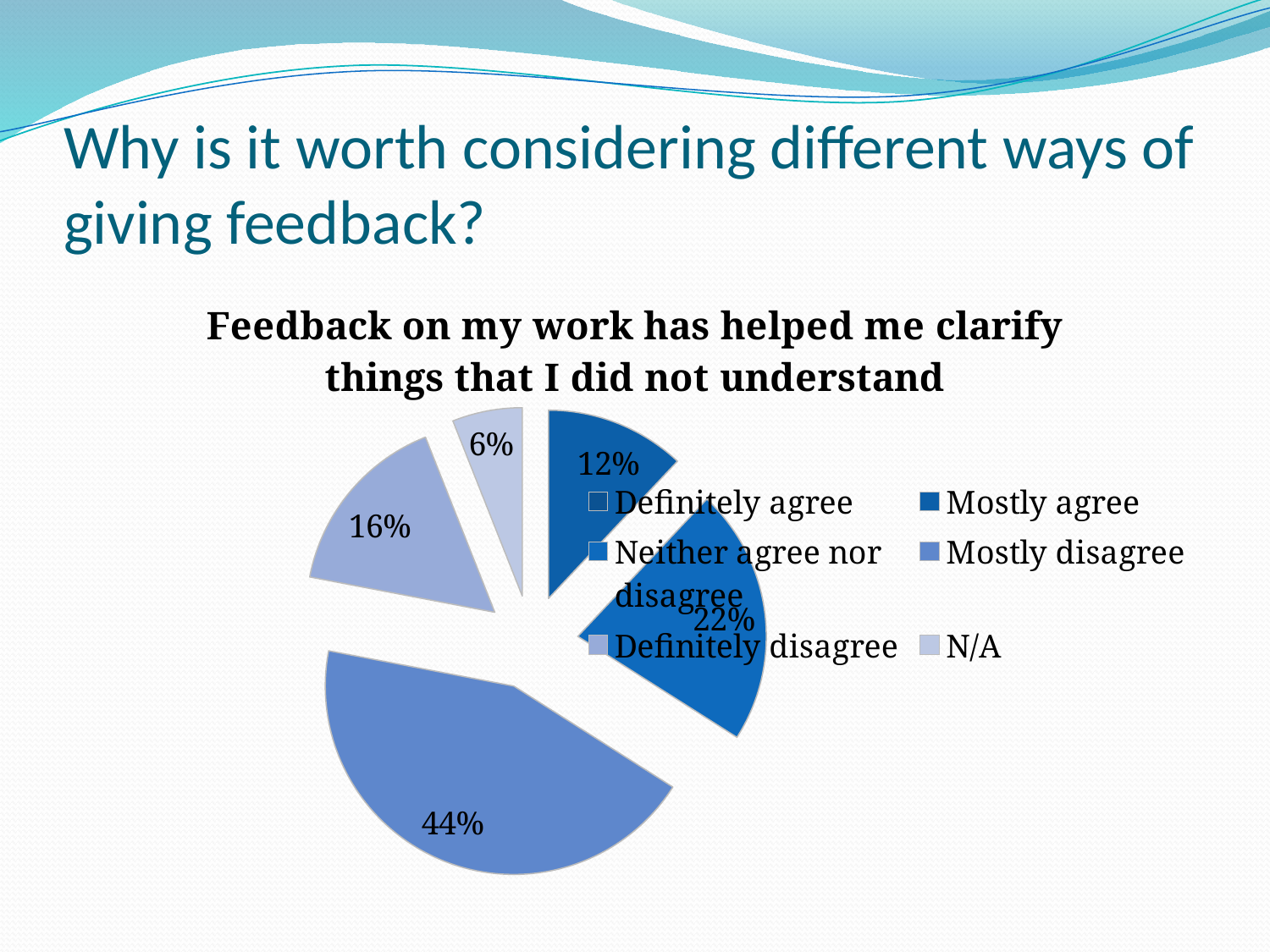
How many entries does the legend of the pie chart list? 6 What is the difference between the 'Neither agree nor disagree' share and the 'Mostly agree' share? 10 percentage points What percentage of respondents chose 'Definitely agree'? 0% Which category has the largest slice of the pie chart? Mostly disagree What percentage of respondents chose 'Mostly disagree'? 44% How many slices with data labels are shown in the pie chart? 5 What is the value of the smallest labelled slice in the pie chart? 6% What is the title of the pie chart? Feedback on my work has helped me clarify things that I did not understand Which is larger, the share for 'Mostly agree' or the share for 'Mostly disagree'? Mostly disagree What percentage of respondents chose 'Mostly agree'? 12% What type of chart is shown on the slide? Pie chart What percentage of respondents chose 'Neither agree nor disagree'? 22%